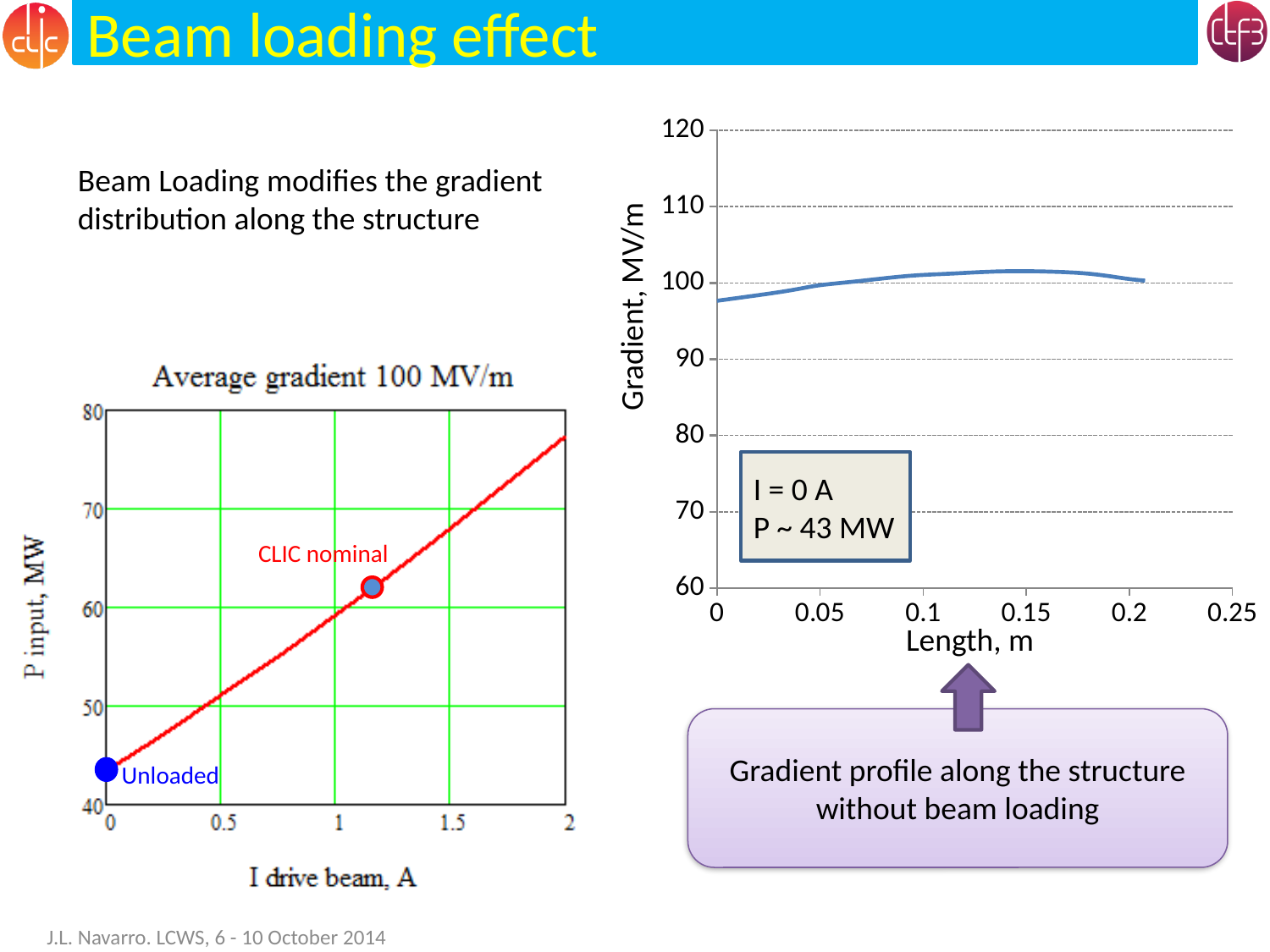
In the left chart titled "Average gradient 100 MV/m", is the P input at the CLIC nominal point greater or less than 70 MW? less In the left chart titled "Average gradient 100 MV/m", is the P input at I drive beam = 0 A greater or less than 50 MW? less In the right chart with the y-axis "Gradient, MV/m", is the gradient at Length = 0.1 m greater or less than 90 MV/m? greater In the right chart with the y-axis "Gradient, MV/m", how many data series are plotted? 1 What kind of chart is the right chart with the y-axis "Gradient, MV/m"? line chart In the left chart titled "Average gradient 100 MV/m", what is the label of the x axis? I drive beam, A In the right chart with the y-axis "Gradient, MV/m", what is the highest value shown on the y axis? 120 In the left chart titled "Average gradient 100 MV/m", does P input rise or fall as I drive beam increases? rise In the left chart titled "Average gradient 100 MV/m", what label is given to the blue point at I drive beam = 0? Unloaded What kind of chart is the left chart titled "Average gradient 100 MV/m"? line chart